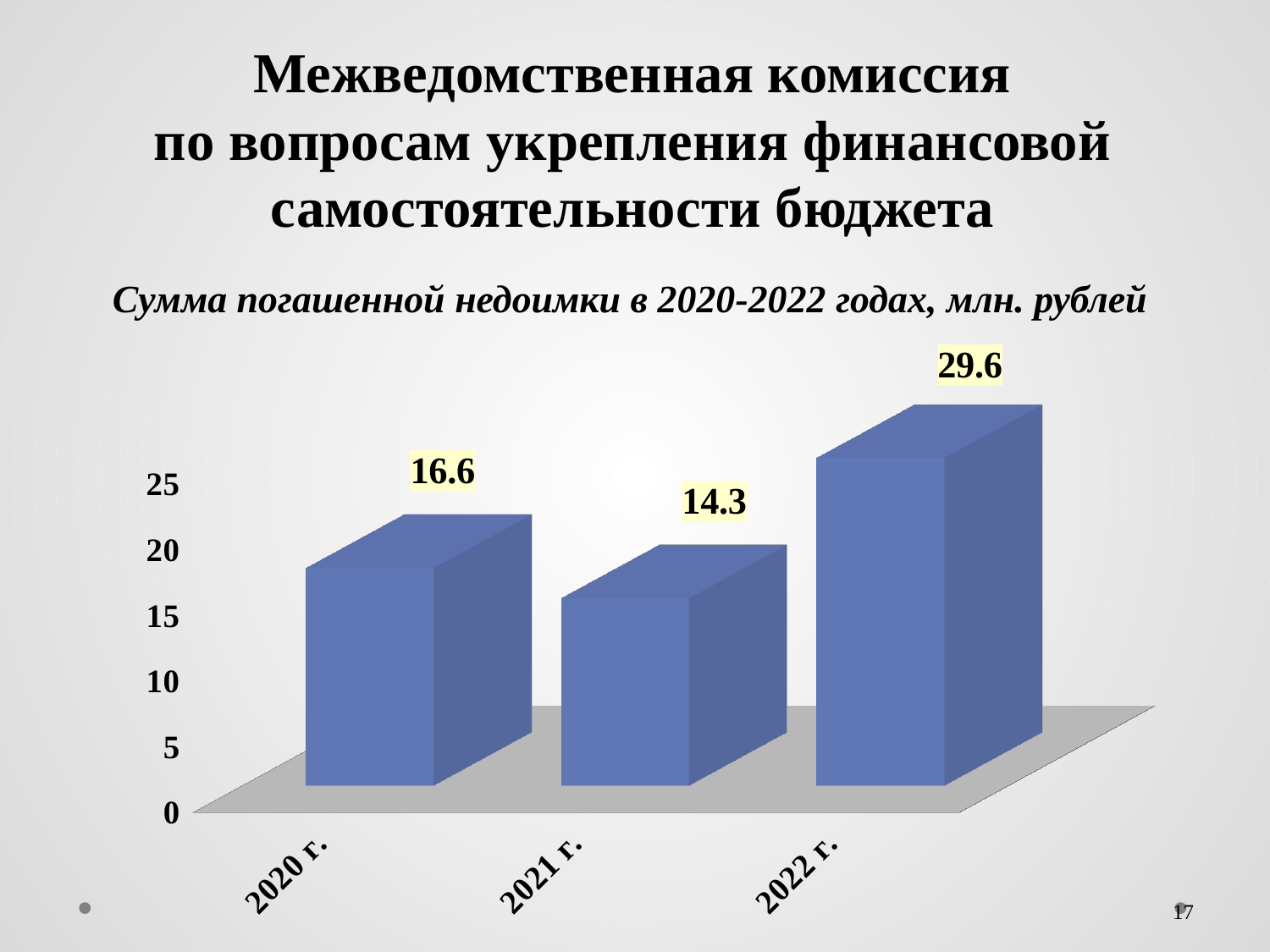
What is the value for 2020 г.? 16.6 What is the title of the chart? Сумма погашенной недоимки в 2020-2022 годах, млн. рублей What is the difference between the values for 2022 г. and 2021 г.? 15.3 What is the difference between the values for 2020 г. and 2021 г.? 2.3 Is the value for 2022 г. greater or less than 25? greater Which year has the lowest value? 2021 г. Which is larger, the value for 2020 г. or the value for 2021 г.? 2020 г. What is the value for 2021 г.? 14.3 Which year has the highest value? 2022 г. What is the value for 2022 г.? 29.6 How many years are shown on the chart? 3 What kind of chart is shown on the slide? bar chart